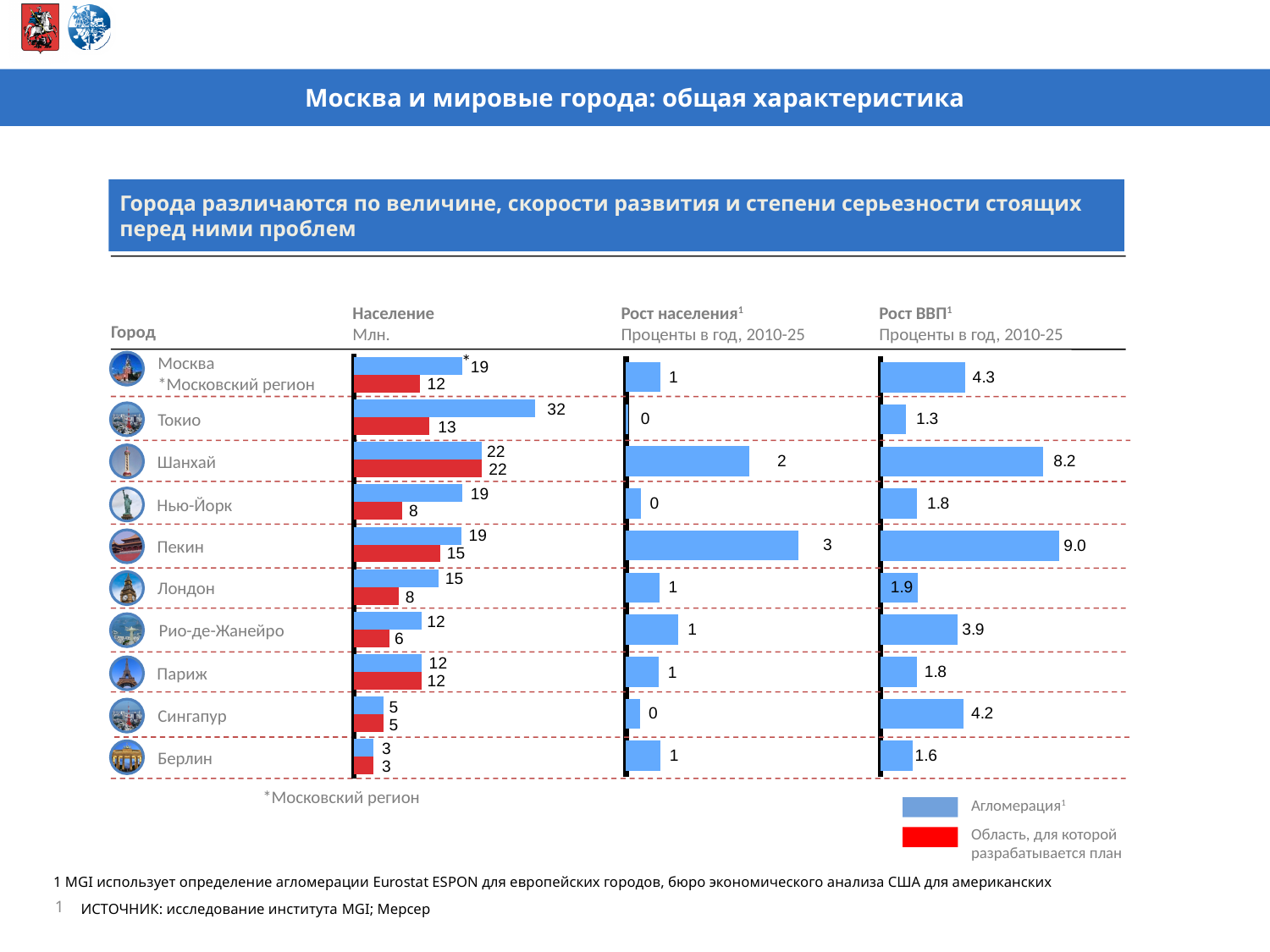
In the Рост ВВП chart, which is larger, the value for Москва or the value for Сингапур? Москва How many series does the legend list? 2 How many cities are shown in the charts? 10 In the Население chart, what is the agglomeration population (blue bar) for Токио? 32 What kind of chart is used to show Население? Bar chart In the Население chart, which city has the largest agglomeration population? Токио In the Рост ВВП chart, what is the value for Шанхай? 8.2 In the Рост населения chart, what is the value for Пекин? 3 In the Рост ВВП chart, which city has the highest value? Пекин In the Рост ВВП chart, what is the difference between Пекин and Шанхай? 0.8 In the Население chart, what is the difference between the agglomeration value and the plan-area value for Токио? 19 In the Рост ВВП chart, which city has the lowest value? Токио